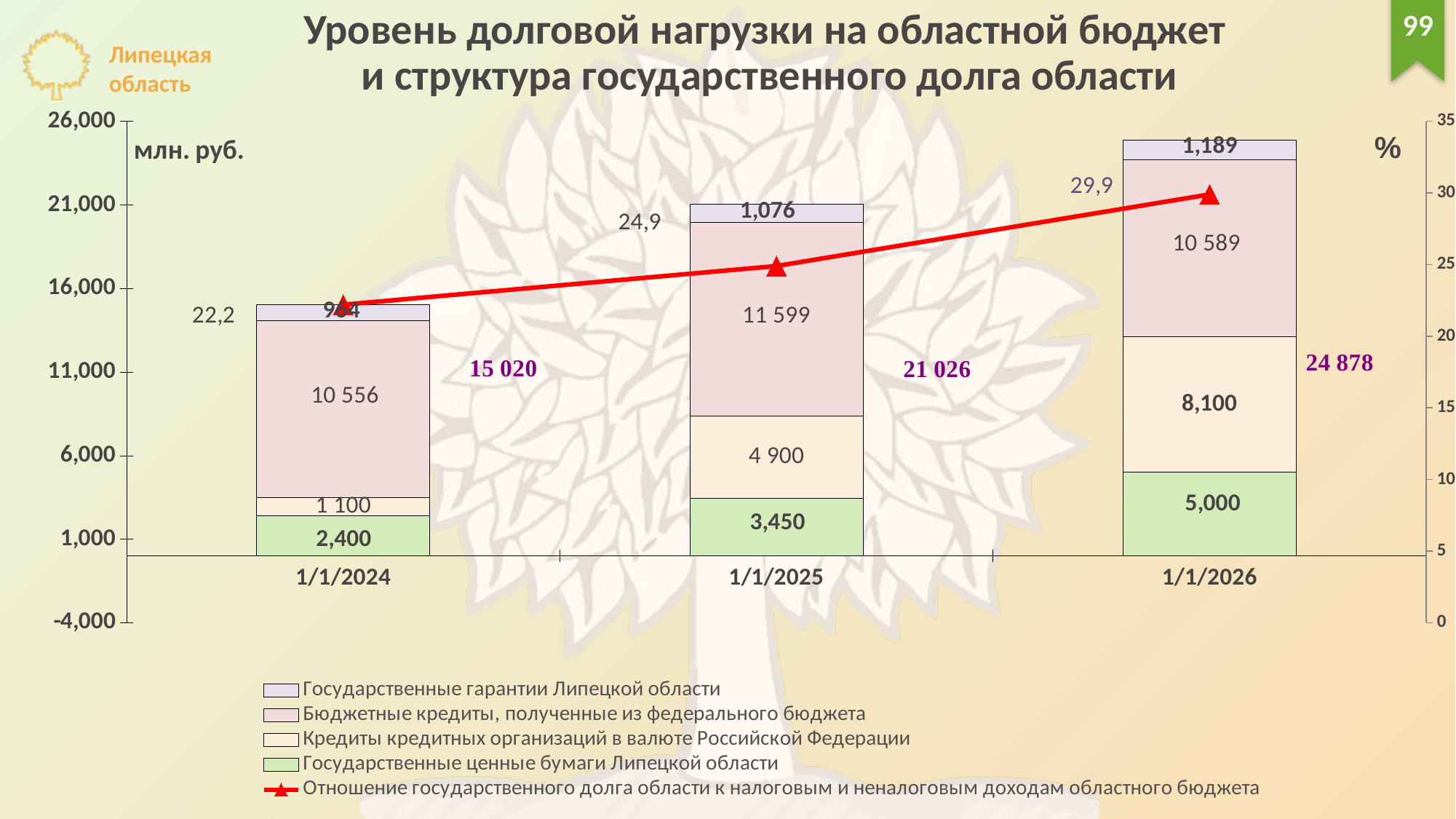
Does the debt-to-revenue ratio line rise or fall from 1/1/2024 to 1/1/2026? rises What is the value of Отношение государственного долга области к налоговым и неналоговым доходам областного бюджета for 1/1/2026? 29,9 What kind of chart is shown on the slide? stacked bar chart with a line How many dates are shown along the x axis of the chart? 3 What is the value of Государственные ценные бумаги Липецкой области for 1/1/2026? 5,000 How many series does the chart legend list? 5 What is the total of the stacked bar for 1/1/2025? 21 026 What is the value of Бюджетные кредиты, полученные из федерального бюджета for 1/1/2025? 11 599 What is the difference between the Кредиты кредитных организаций values for 1/1/2026 and 1/1/2025? 3 200 On which date is the value of Государственные ценные бумаги Липецкой области the lowest? 1/1/2024 What is the value of Кредиты кредитных организаций в валюте Российской Федерации for 1/1/2024? 1 100 On which date is the total state debt (stacked bar) the highest? 1/1/2026